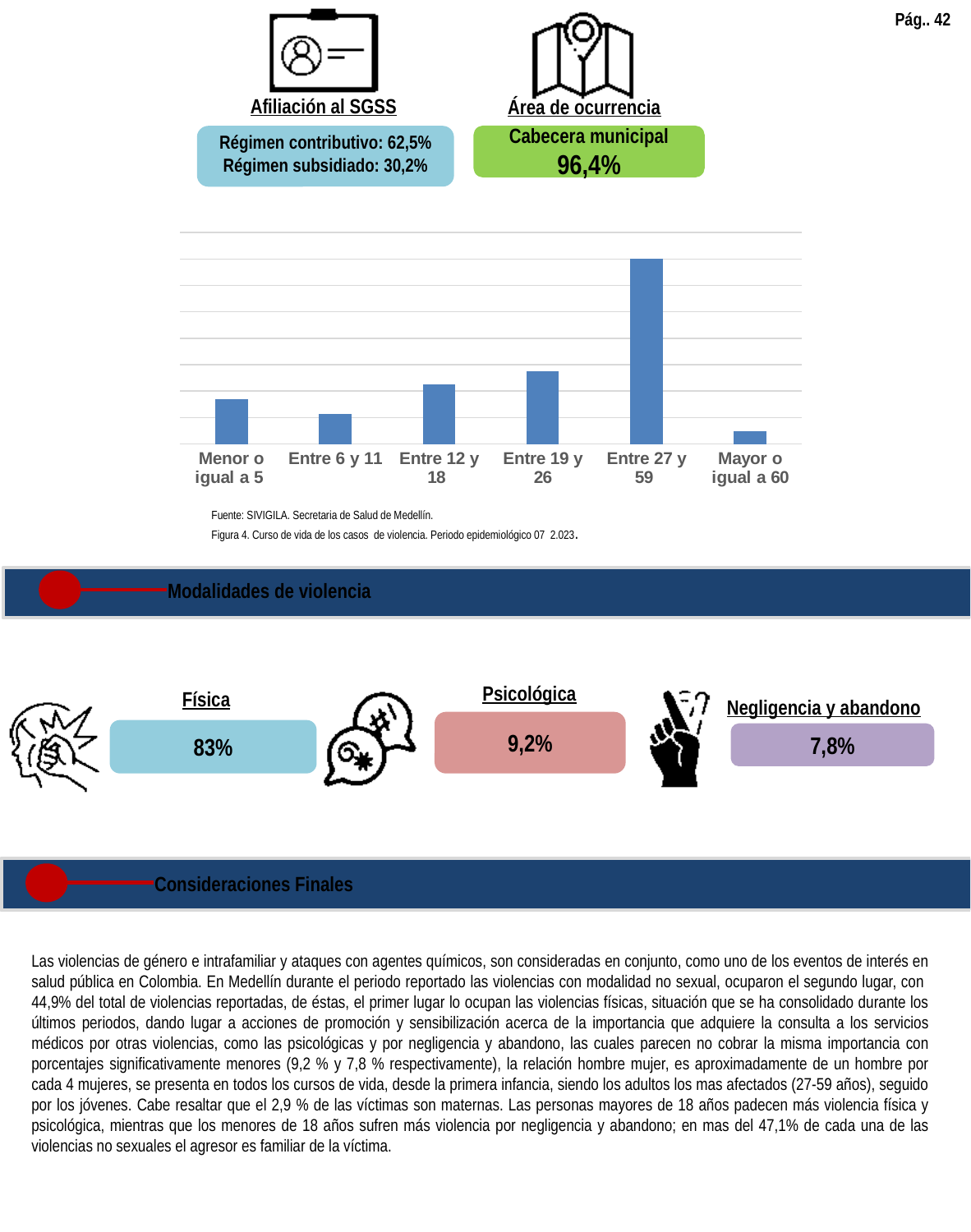
Do the bars rise or fall from Entre 6 y 11 through Entre 27 y 59? rise Do the bars rise or fall from Entre 27 y 59 to Mayor o igual a 60? fall How many age categories are shown on the x axis of the bar chart? 6 Which age category has the highest bar in the chart? Entre 27 y 59 Which is larger in the chart, the bar for Entre 27 y 59 or the bar for Entre 19 y 26? Entre 27 y 59 Which age category has the second highest bar in the chart? Entre 19 y 26 What source is cited below the bar chart? SIVIGILA. Secretaria de Salud de Medellín. What is the figure number and caption given below the bar chart? Figura 4. Curso de vida de los casos de violencia. Periodo epidemiológico 07 2.023 What kind of chart is shown on the slide? bar chart Which age category has the lowest bar in the chart? Mayor o igual a 60 Which is larger in the chart, the bar for Entre 19 y 26 or the bar for Entre 12 y 18? Entre 19 y 26 Which is larger in the chart, the bar for Menor o igual a 5 or the bar for Entre 6 y 11? Menor o igual a 5